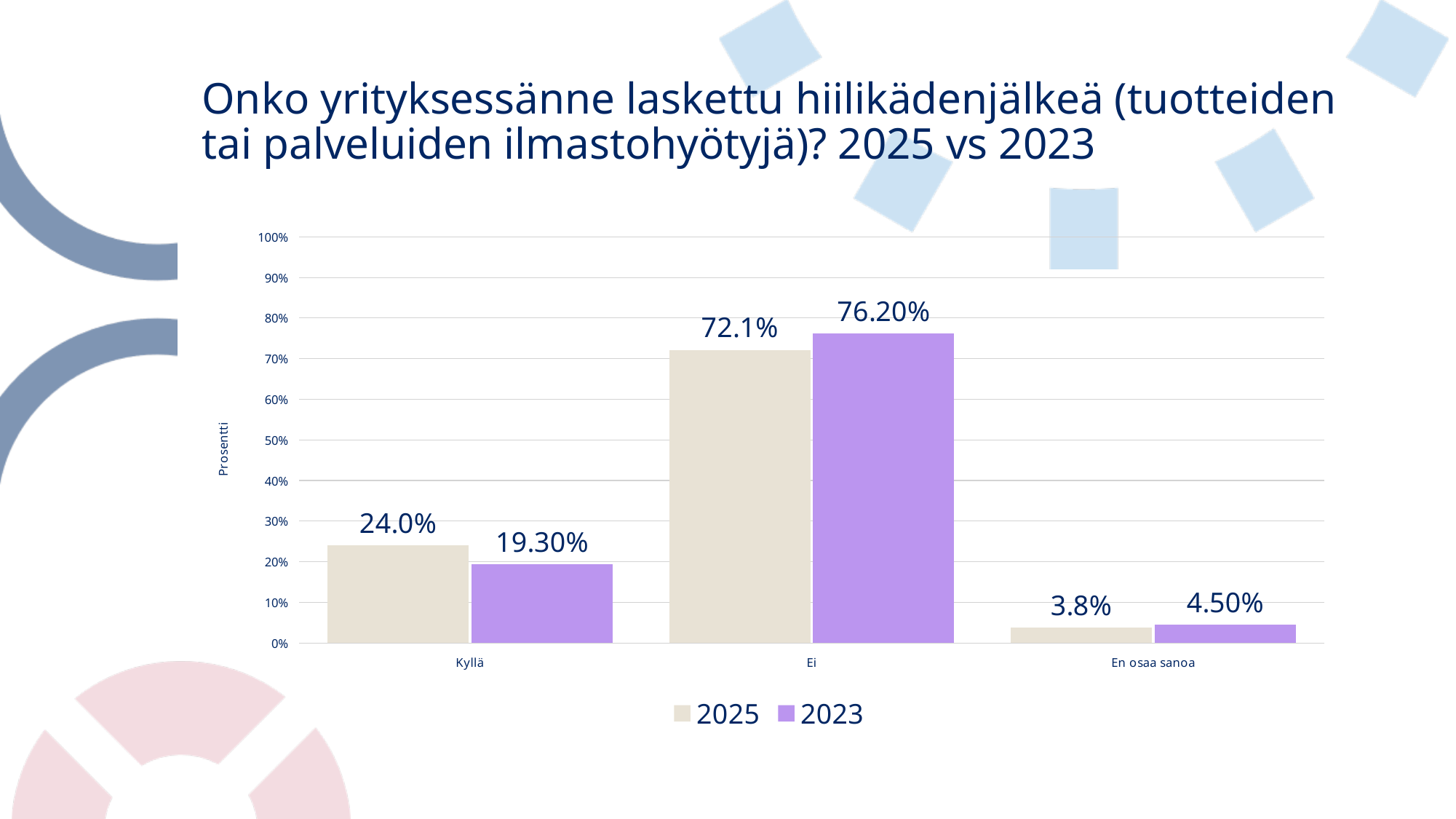
What is the label of the vertical axis? Prosentti How many categories are shown on the x axis? 3 Which is larger for Kyllä: the 2025 value or the 2023 value? 2025 Which category has the highest value in the 2025 series? Ei Which category has the lowest value in the 2023 series? En osaa sanoa What is the value for Ei in the 2023 series? 76.20% What kind of chart is shown on the slide? Bar chart What is the value for En osaa sanoa in the 2025 series? 3.8% What is the value for Kyllä in the 2023 series? 19.30% What is the value for Kyllä in the 2025 series? 24.0% What is the difference between the 2023 and 2025 values for Ei? 4.1 percentage points How many series does the legend list? 2